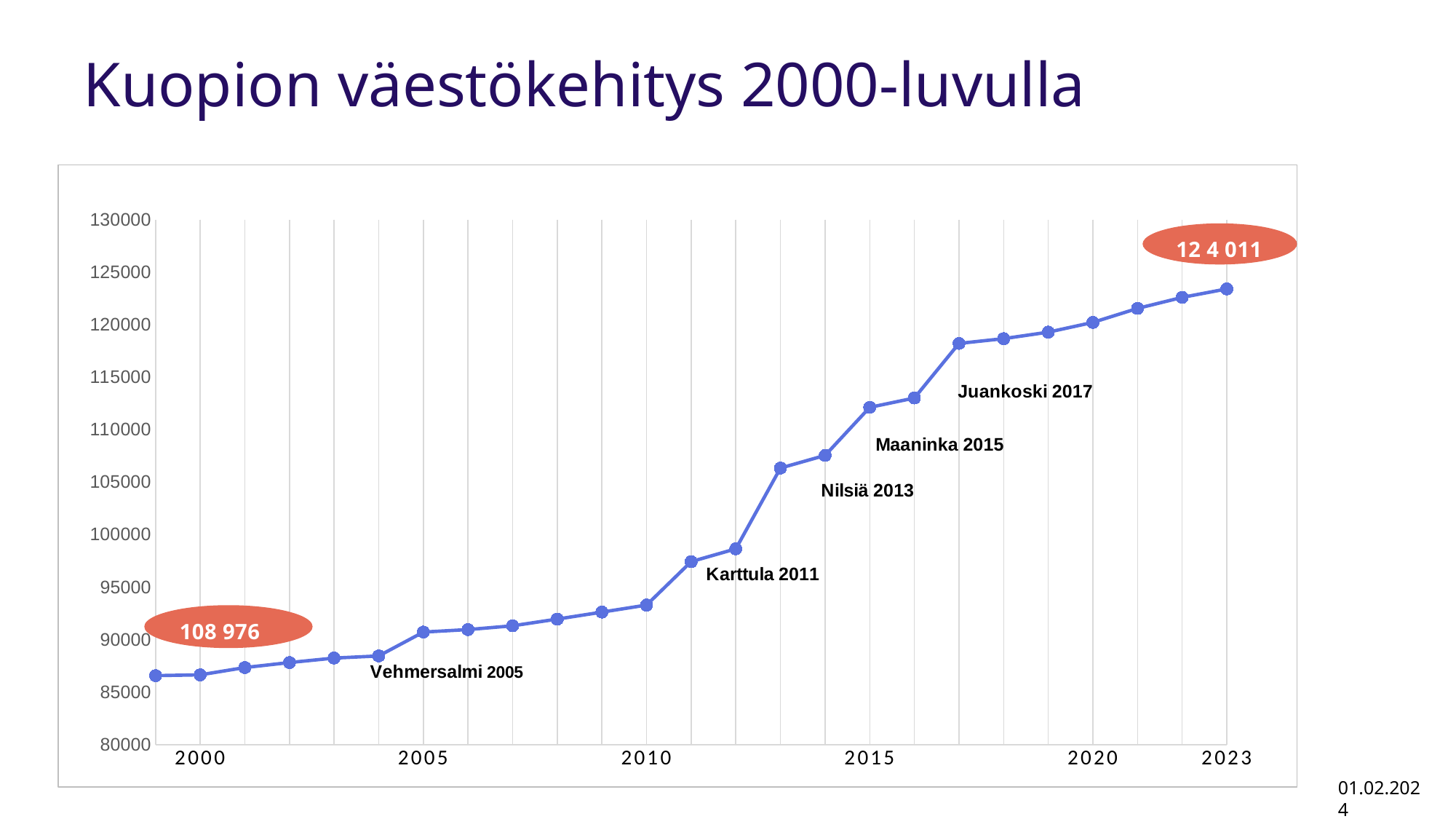
Is the value for 2000 greater or less than 90000? less Which municipality merger is annotated at 2011 on the chart? Karttula Which is larger, the value for 2015 or the value for 2010? 2015 Is the value for 2013 greater or less than 105000? greater What kind of chart is shown on the slide? line chart Is the value for 2010 greater or less than 95000? less What is the title of the slide? Kuopion väestökehitys 2000-luvulla What is the lowest value shown on the vertical axis? 80000 Which year has the highest value on the chart? 2023 Do the values generally rise or fall from 2000 to 2023? rise